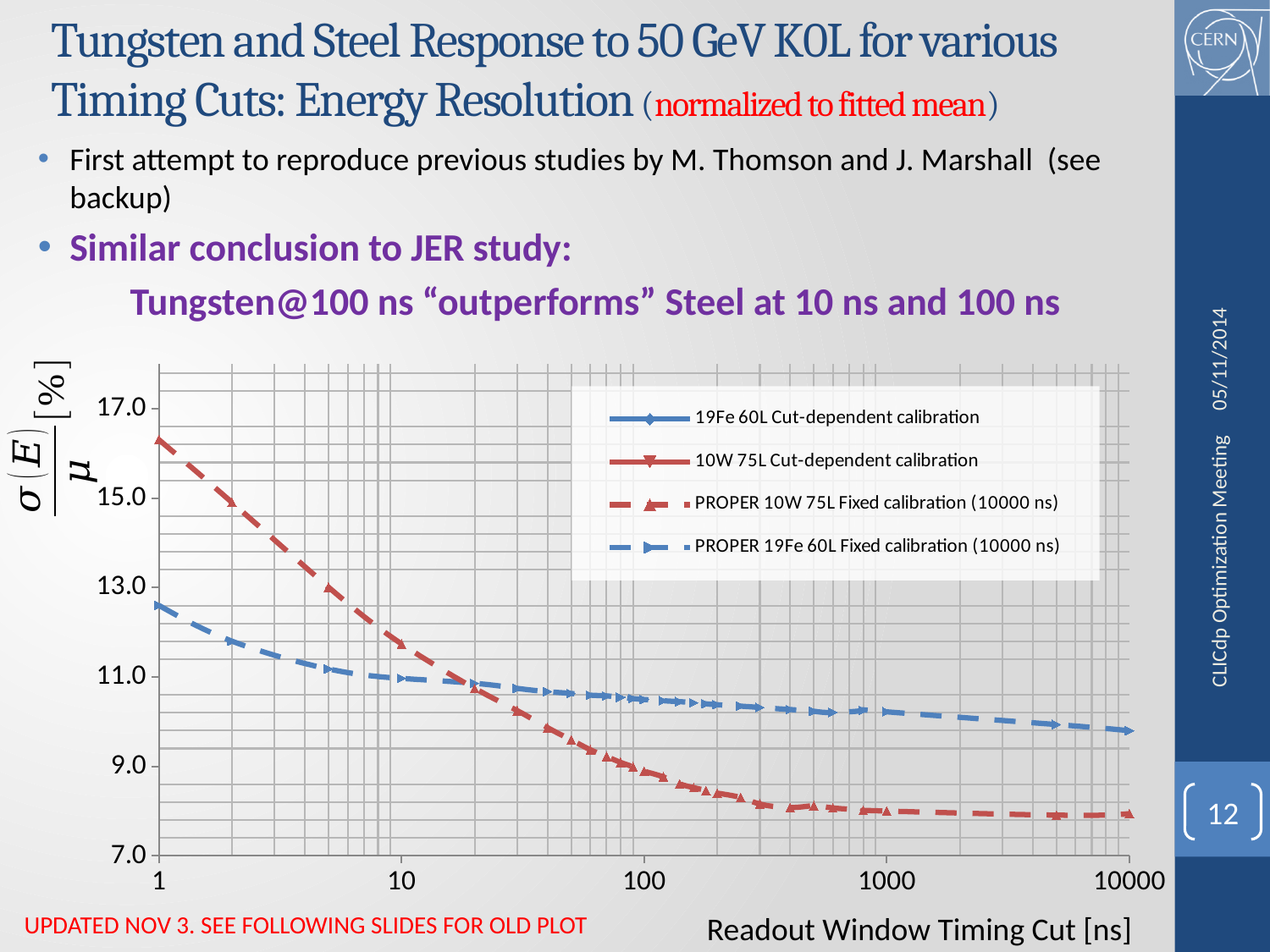
What is the x-axis label of the chart? Readout Window Timing Cut [ns] How many series does the chart legend list? 4 Is the value of the PROPER 10W 75L Fixed calibration series at a timing cut of 10000 ns greater or less than 9.0? less Is the value of the PROPER 19Fe 60L Fixed calibration series at a timing cut of 10000 ns greater or less than 9.0? greater Is the value of the PROPER 19Fe 60L Fixed calibration series at a timing cut of 1 ns greater or less than 13.0? less Does the PROPER 10W 75L Fixed calibration (10000 ns) series rise or fall as the timing cut increases along the x axis? fall What is the highest tick value shown on the y axis of the chart? 17.0 At a timing cut of 1 ns, which series has the higher value: PROPER 10W 75L Fixed calibration or PROPER 19Fe 60L Fixed calibration? PROPER 10W 75L Fixed calibration (10000 ns) Does the PROPER 19Fe 60L Fixed calibration (10000 ns) series rise or fall as the timing cut increases along the x axis? fall What kind of chart is shown on the slide? line chart At a timing cut of 1000 ns, which series has the higher value: PROPER 10W 75L Fixed calibration or PROPER 19Fe 60L Fixed calibration? PROPER 19Fe 60L Fixed calibration (10000 ns)